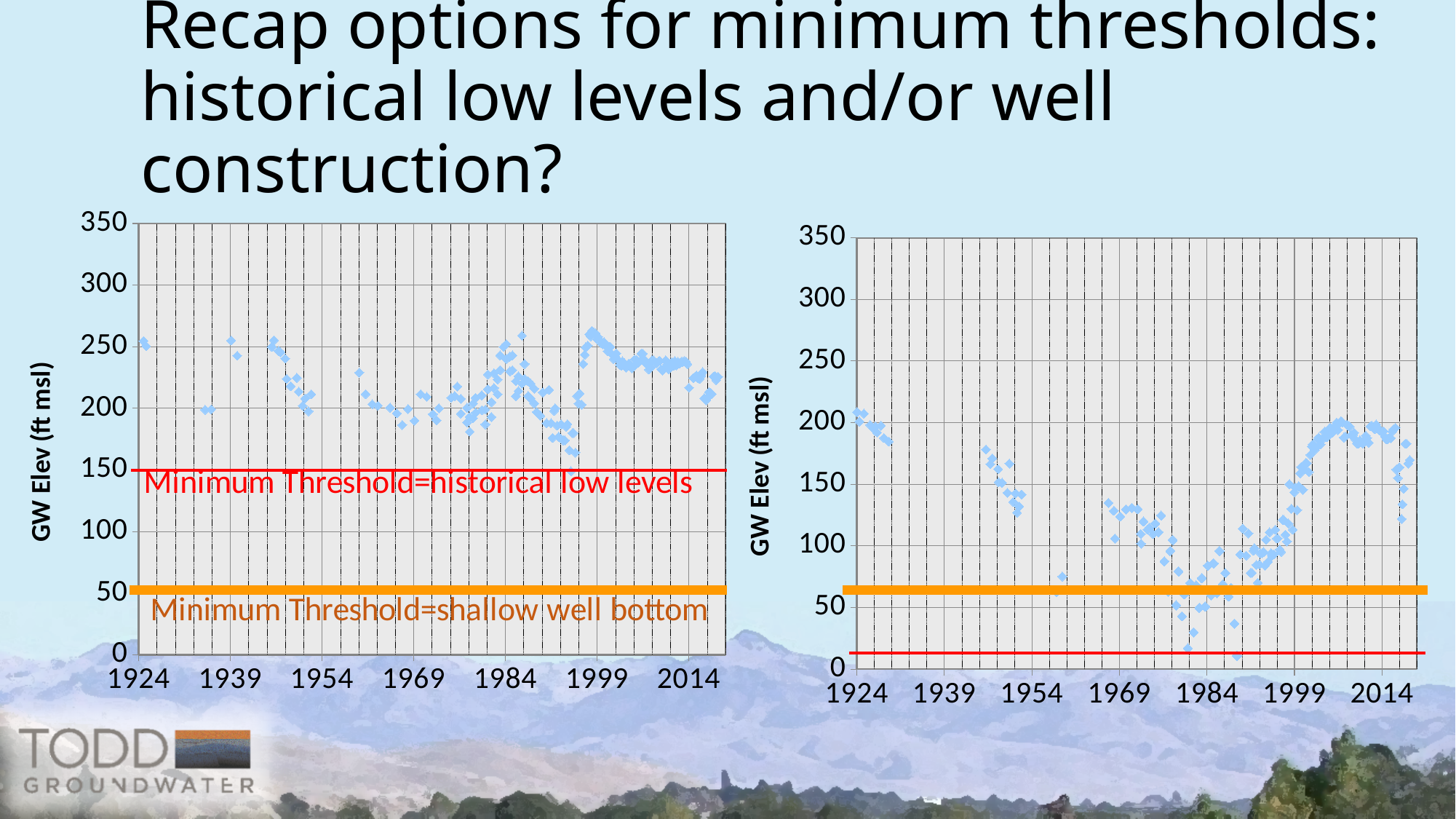
On the left chart, is the groundwater elevation around 1924 greater or less than 200? greater On the right chart, is the groundwater elevation higher around 1924 or around 1984? 1924 On the right chart, is the groundwater elevation around 1924 greater or less than 150? greater Around 1924, which chart shows the higher groundwater elevation, the left chart or the right chart? left chart On the right chart, do the groundwater elevations generally rise or fall between 1984 and 2009? rise On the left chart, what is the label on the orange horizontal line? Minimum Threshold=shallow well bottom On the right chart, what is the first year shown on the x axis? 1924 What kind of chart is the left chart on the slide? scatter chart On the left chart, is the groundwater elevation around 2014 greater or less than 200? greater On the left chart, what is the highest value shown on the y axis? 350 On the left chart, what is the label on the red horizontal line? Minimum Threshold=historical low levels